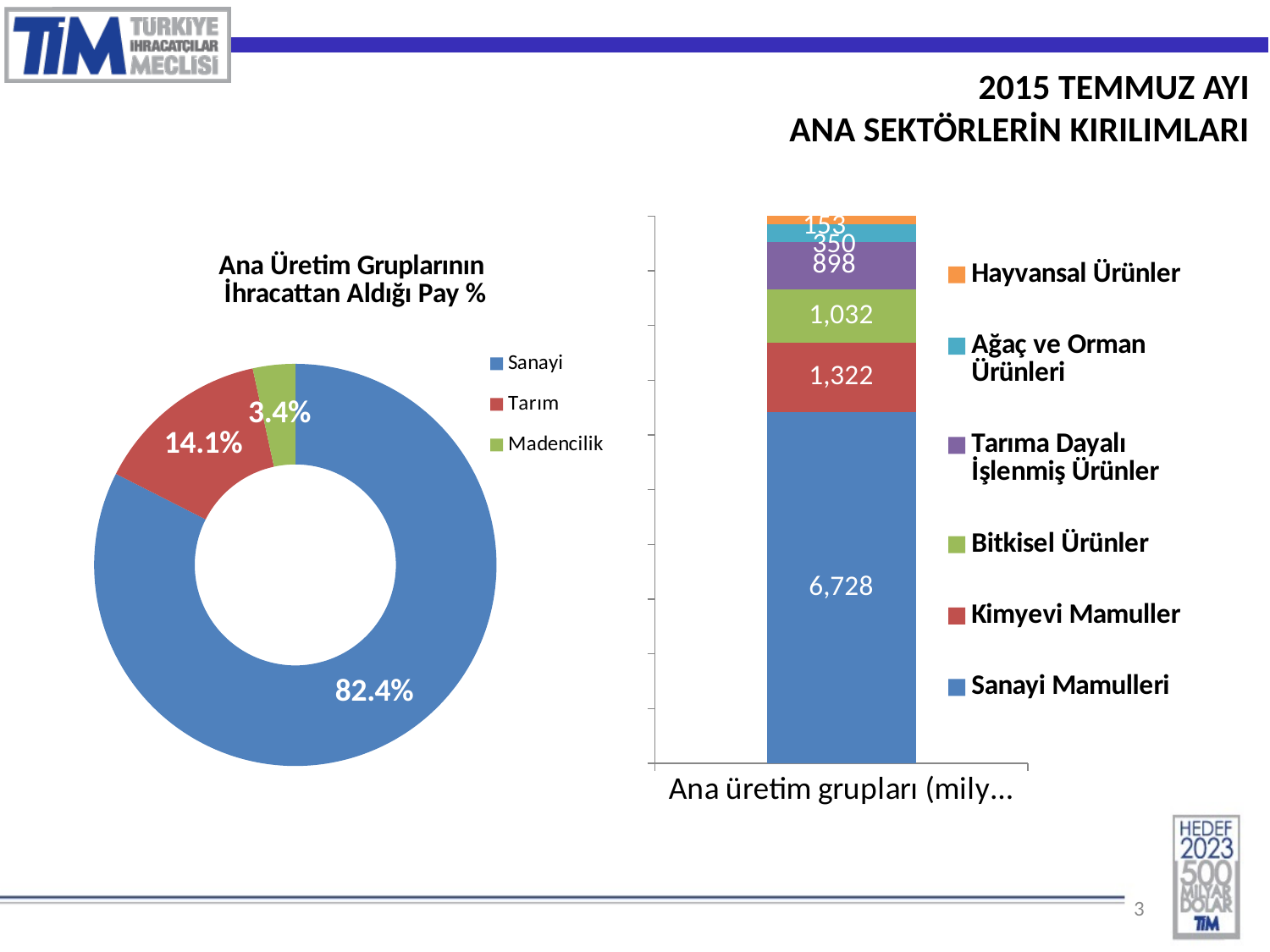
In the doughnut chart on the left, which category has the smallest share? Madencilik In the stacked bar chart on the right, what is the value for Kimyevi Mamuller? 1,322 In the stacked bar chart on the right, what is the difference between Kimyevi Mamuller and Bitkisel Ürünler? 290 In the stacked bar chart on the right, which series has the smallest value? Hayvansal Ürünler In the stacked bar chart on the right, what is the value for Sanayi Mamulleri? 6,728 In the doughnut chart titled 'Ana Üretim Gruplarının İhracattan Aldığı Pay %', what share does Sanayi have? 82.4% In the doughnut chart on the left, how many categories does the legend list? 3 In the doughnut chart on the left, what share does Tarım have? 14.1% In the stacked bar chart on the right, how many series does the legend list? 6 In the stacked bar chart on the right, what is the total of all segments in the bar? 10,483 In the stacked bar chart on the right, what is the value for Bitkisel Ürünler? 1,032 What kind of chart is the chart on the left of the slide? Doughnut chart